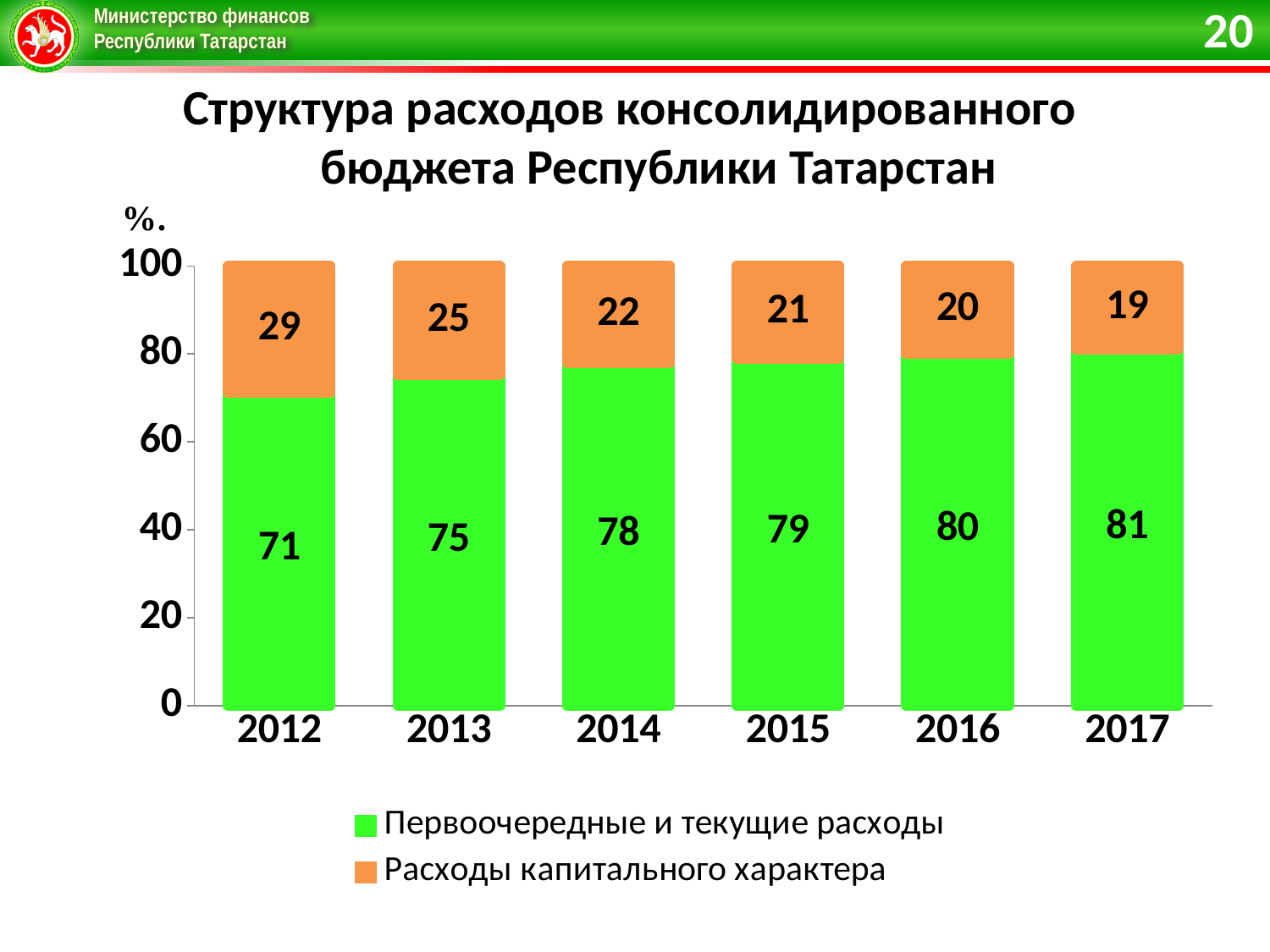
What is the value for Расходы капитального характера in 2014? 22 How many series does the legend list? 2 Which is larger: Расходы капитального характера in 2013 or in 2016? 2013 How many years are shown on the x axis? 6 In which year is Расходы капитального характера lowest? 2017 Do the values for Первоочередные и текущие расходы rise or fall from 2012 to 2017? rise What kind of chart is shown on the slide? stacked bar chart What is the total of the stacked bar for 2015? 100 In which year is Первоочередные и текущие расходы highest? 2017 What is the difference between Первоочередные и текущие расходы in 2017 and in 2012? 10 What is the value for Расходы капитального характера in 2017? 19 What is the value for Первоочередные и текущие расходы in 2012? 71